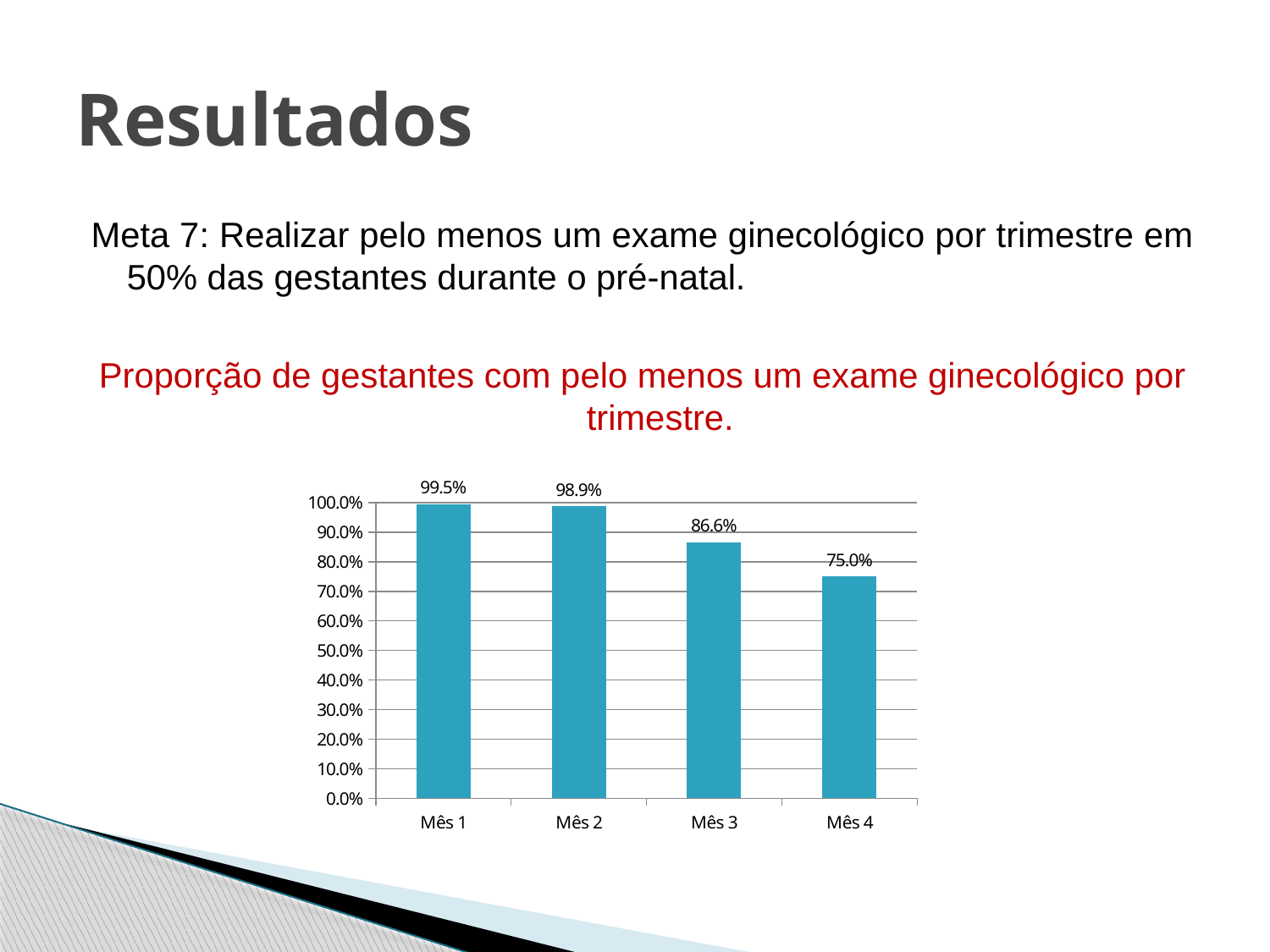
What is the difference between the values for Mês 2 and Mês 3? 12.3% What is the difference between the values for Mês 1 and Mês 4? 24.5% Which month has the highest value? Mês 1 Is the value for Mês 4 greater or less than 80.0%? less Which month has the lowest value? Mês 4 What is the value for Mês 3? 86.6% Do the values rise or fall from Mês 1 to Mês 4? fall What is the value for Mês 4? 75.0% Which is larger, the value for Mês 3 or the value for Mês 4? Mês 3 How many months are shown on the x axis? 4 What is the value for Mês 1? 99.5% What kind of chart is shown on the slide? bar chart